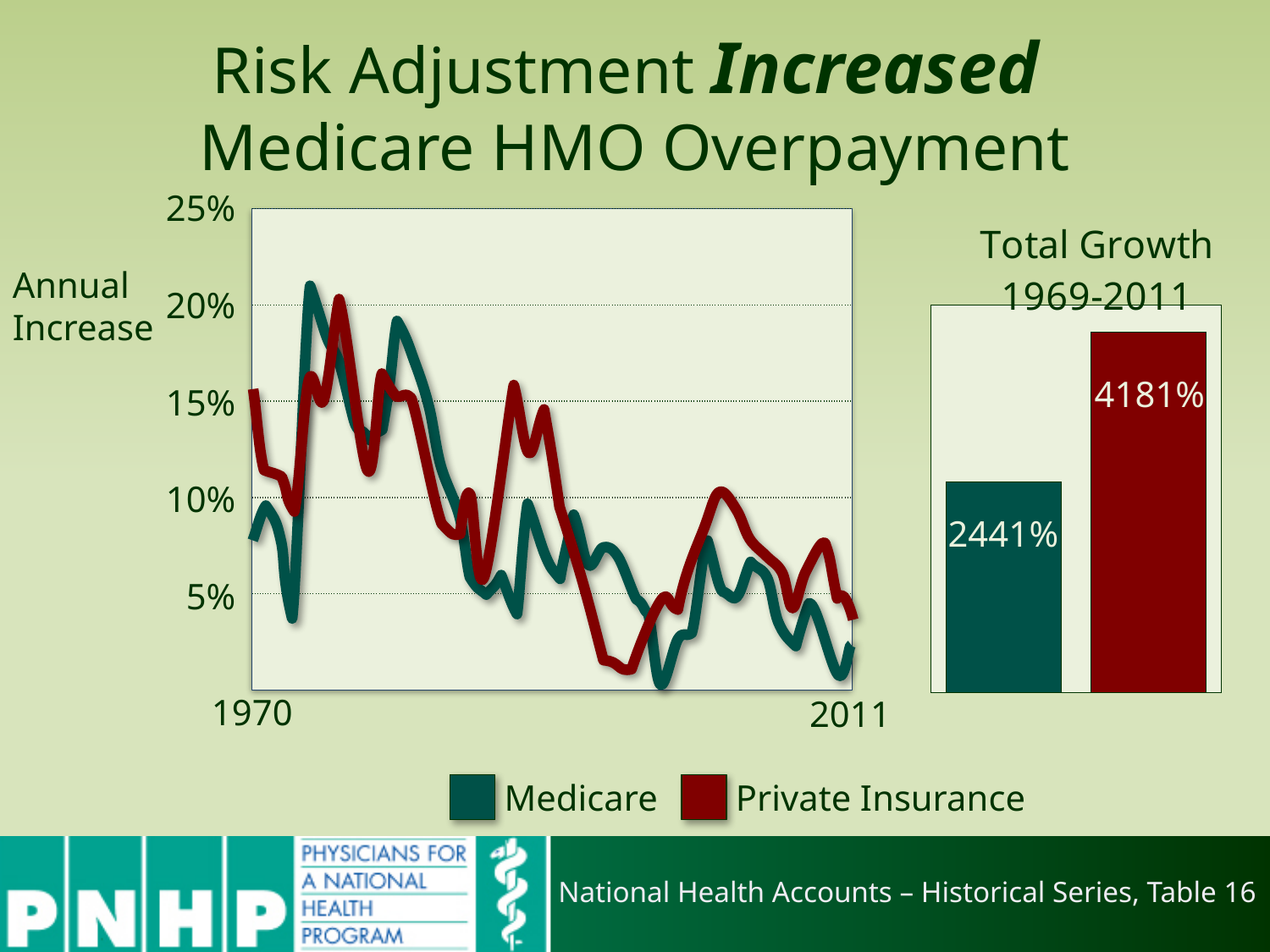
What kind of chart is the Annual Increase chart on the left? line chart How many series does the legend list? 2 In the Total Growth 1969-2011 bar chart, what is the value for Medicare? 2441% In the Total Growth 1969-2011 bar chart, what is the difference between the Private Insurance and Medicare values? 1740% In the Annual Increase line chart, is the value for Medicare in 2011 greater or less than 5%? less In the Annual Increase line chart, is the peak value for Medicare in the early 1970s greater or less than 20%? greater In the Annual Increase line chart, do the annual increase values generally rise or fall from 1970 to 2011? fall In the Total Growth 1969-2011 bar chart, which series has the higher total growth? Private Insurance In the Total Growth 1969-2011 chart, is the Medicare value larger or smaller than the Private Insurance value? smaller What kind of chart is the Total Growth 1969-2011 chart on the right? bar chart In the Total Growth 1969-2011 bar chart, which series has the lower total growth? Medicare In the Total Growth 1969-2011 bar chart, what is the value for Private Insurance? 4181%